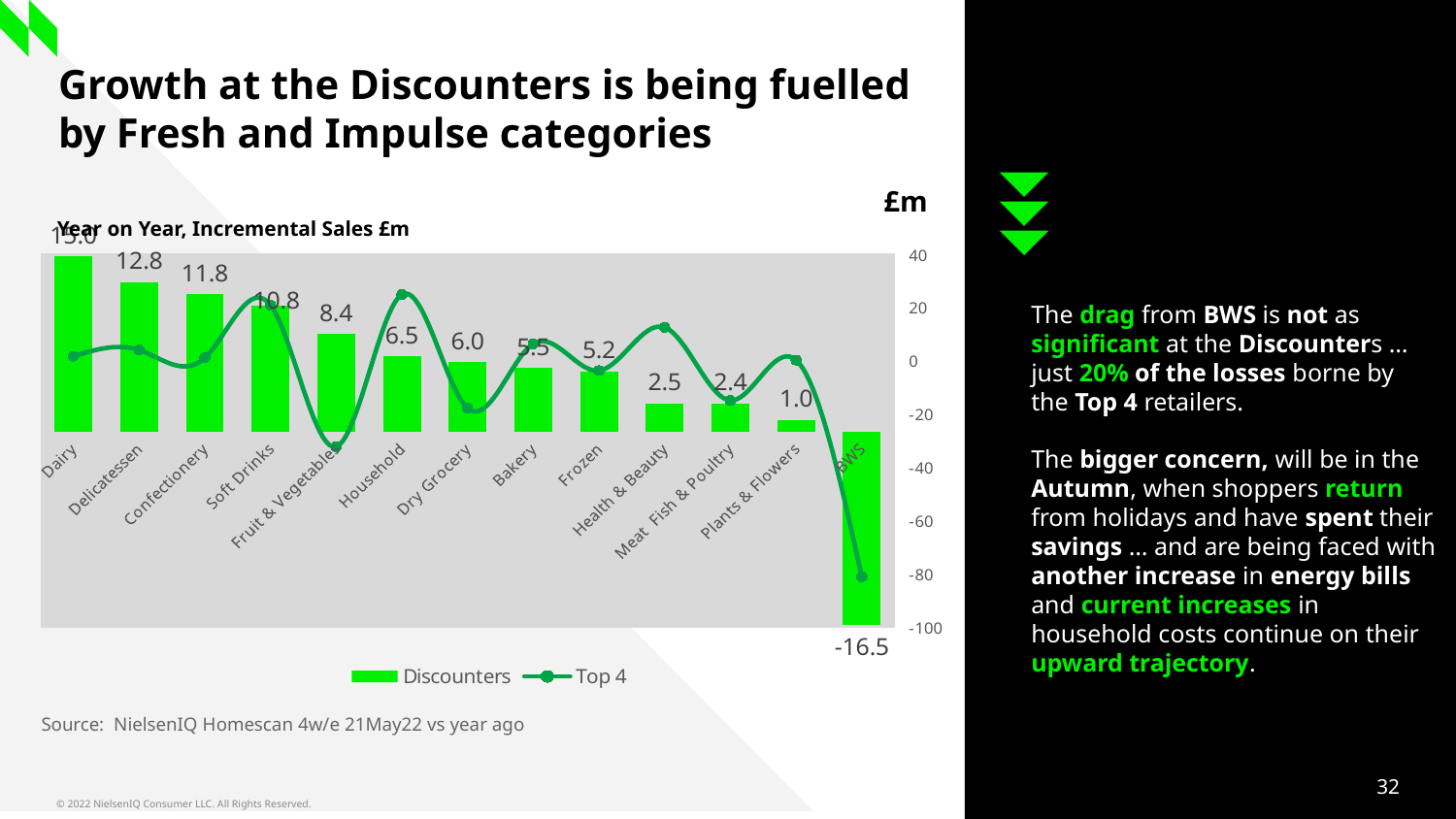
Which has the larger Discounters value, Fruit & Vegetables or Dry Grocery? Fruit & Vegetables Is the Top 4 value for BWS greater or less than -60? less What is the Discounters value for Frozen? 5.2 Which category has the highest Discounters value? Dairy How many categories are shown on the x axis? 13 Which category has the lowest Discounters value? BWS What is the difference between the Discounters values for Confectionery and Household? 5.3 What is the Discounters value for Delicatessen? 12.8 How many series does the legend list? 2 What is the Discounters value for BWS? -16.5 What kind of chart is this? Combined bar and line chart Do the Discounters bars rise or fall from Dairy to BWS along the x axis? fall